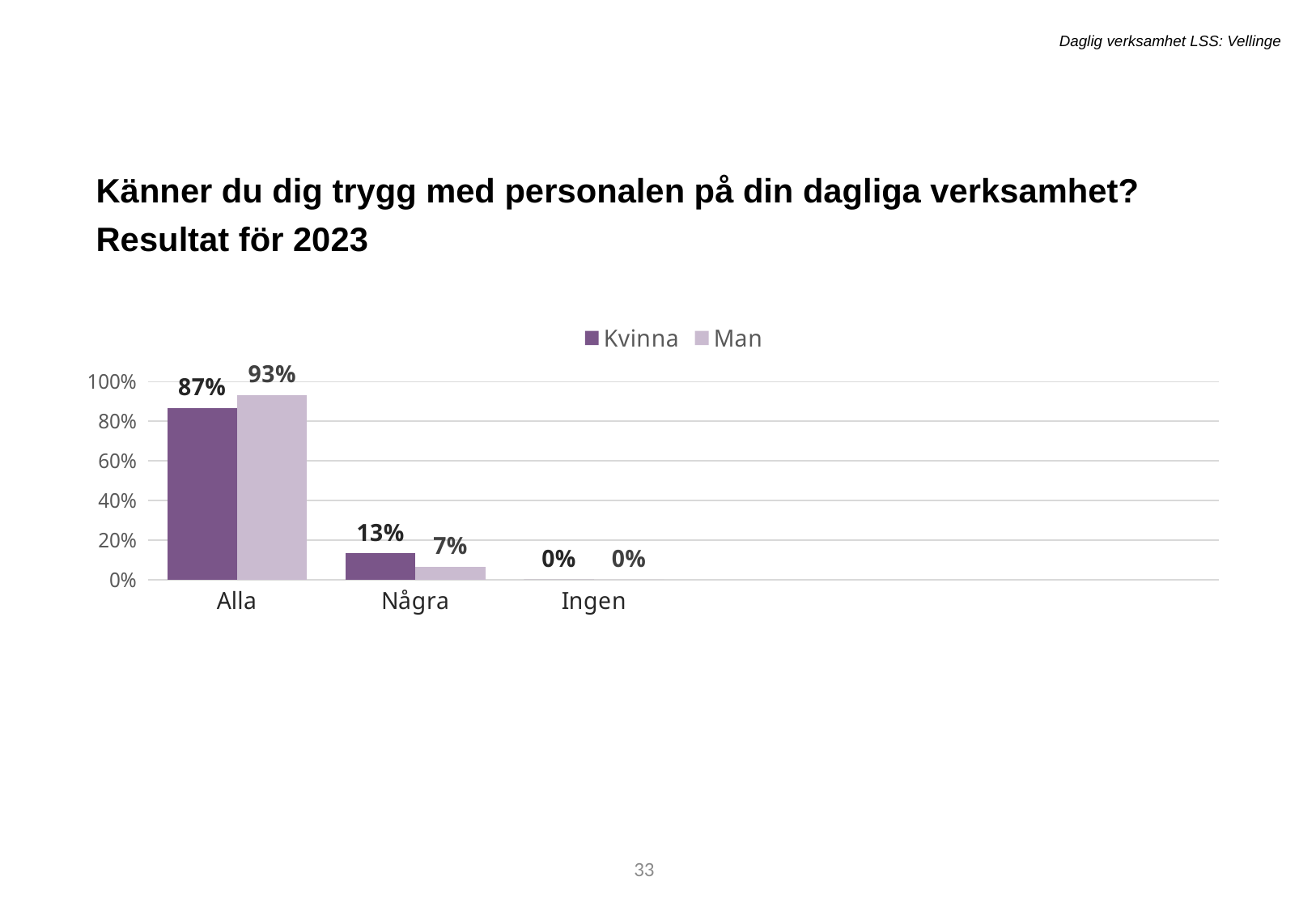
What is the value for Kvinna in the Några category? 13% What is the value for Man in the Några category? 7% Which category has the highest value for the Man series? Alla How many series does the legend list? 2 What is the value for Kvinna in the Ingen category? 0% How many categories are shown on the x axis? 3 What is the difference between the Man and Kvinna values in the Alla category? 6% What is the value for Man in the Alla category? 93% In the Några category, which series has the larger value, Kvinna or Man? Kvinna What kind of chart is shown on the slide? Bar chart Which category has the lowest value for the Kvinna series? Ingen What is the value for Kvinna in the Alla category? 87%